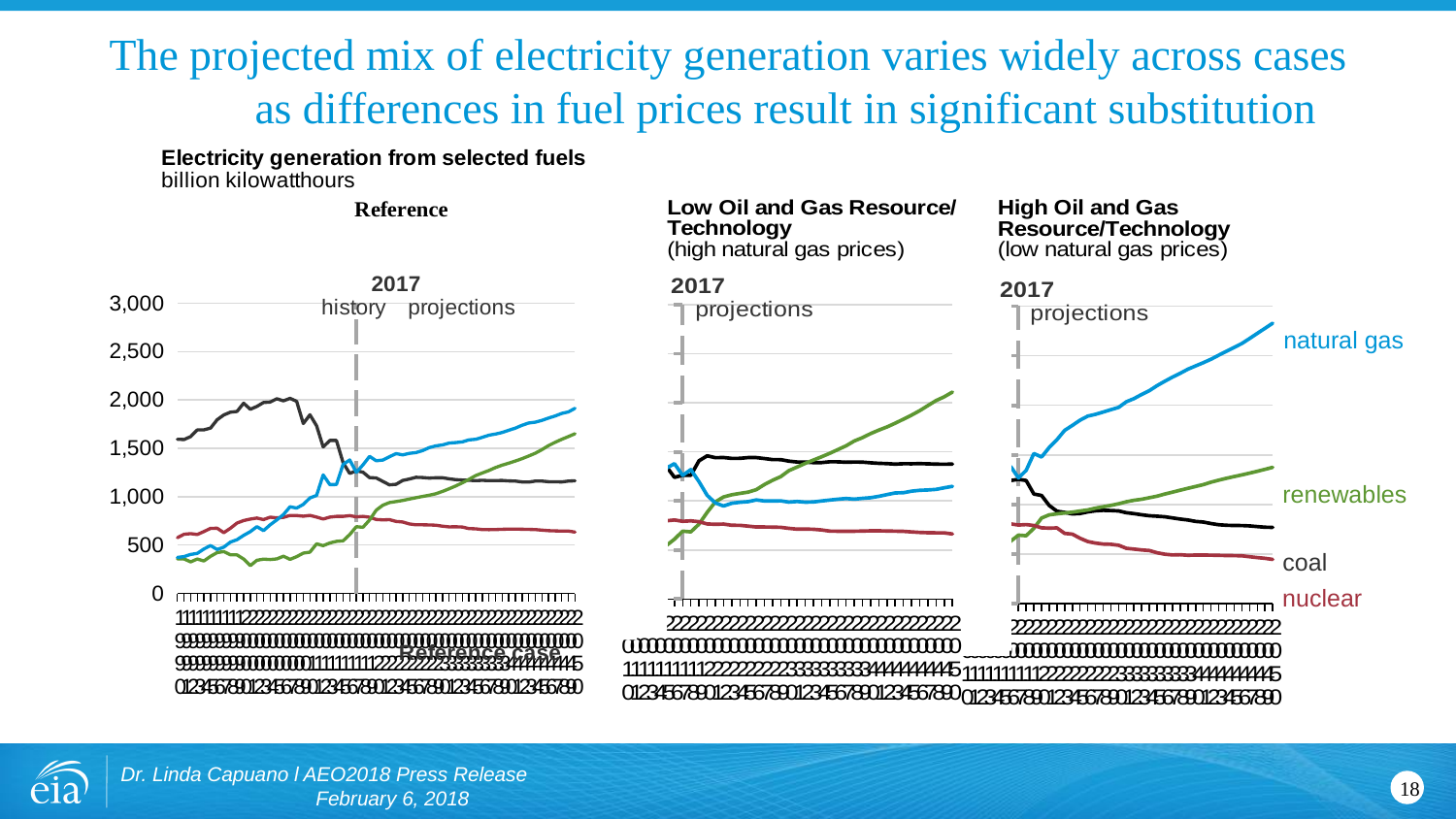
In the Reference chart, is the value for coal at the end of the projection period greater or less than 1,500? less In the Reference chart, is the value for natural gas at the end of the projection period greater or less than 1,500? greater In the High Oil and Gas Resource/Technology chart, is the value for natural gas at the end of the projection period greater or less than 2,500? greater What unit is given for the electricity generation charts? billion kilowatthours How many fuel series are labelled on the right of the charts? 4 In the Low Oil and Gas Resource/Technology chart, do renewables rise or fall over the projection period? rise In the Reference chart, which fuel has the highest value at the end of the projection period? natural gas In the Low Oil and Gas Resource/Technology chart, which fuel has the highest value at the end of the projection period? renewables In the High Oil and Gas Resource/Technology chart, does coal rise or fall over the projection period? fall In the Reference chart, which fuel has the lowest value at the end of the projection period? nuclear What kind of chart is the Reference chart? line chart In the High Oil and Gas Resource/Technology chart, which is larger at the end of the projection period, renewables or coal? renewables